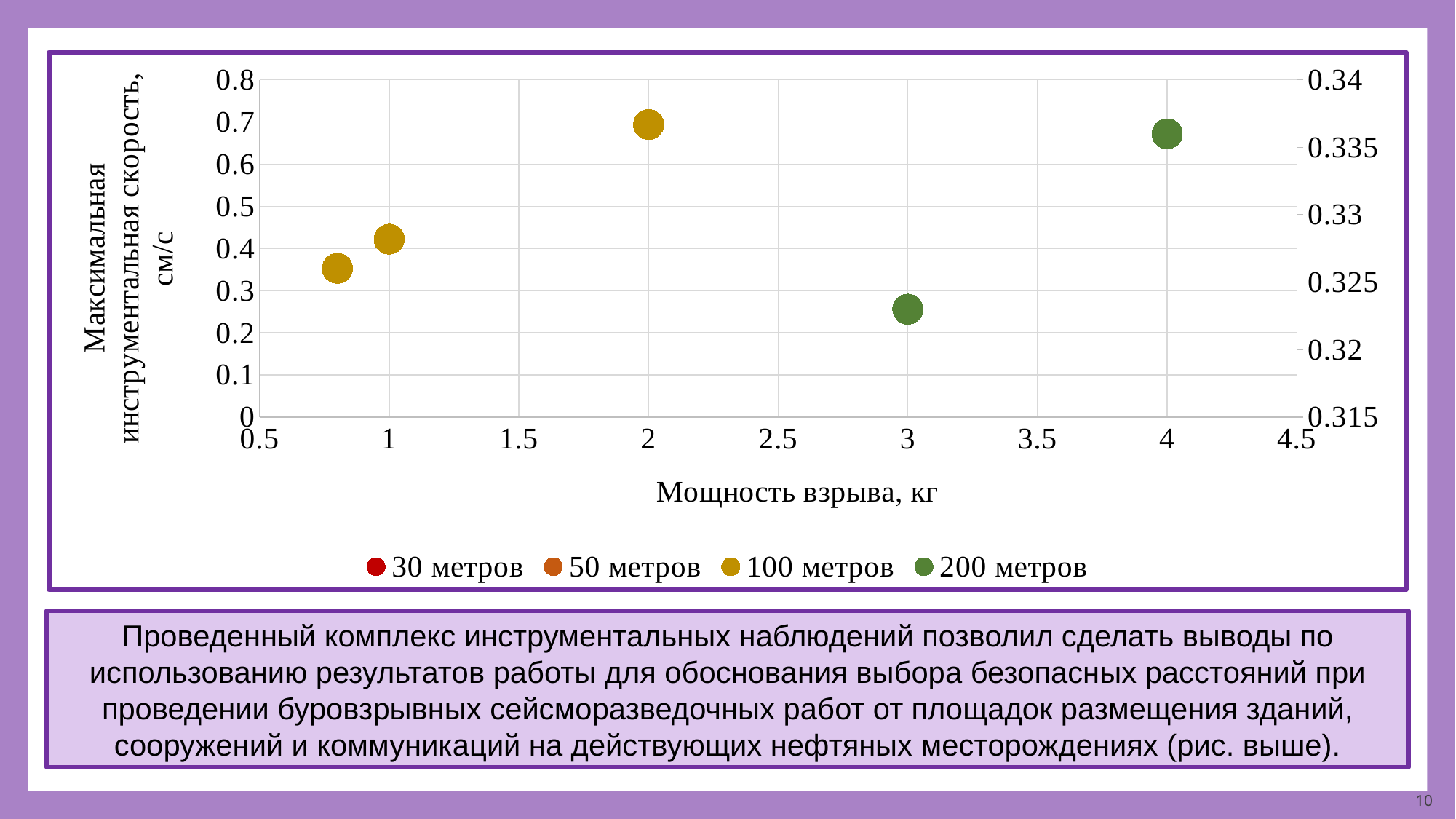
How many data points are plotted for the 200 метров series? 2 How many data points are plotted for the 100 метров series? 3 What is the title of the x axis? Мощность взрыва, кг Do the values of the 100 метров series rise or fall as Мощность взрыва increases? rise How many series does the legend list? 4 Which series has the point with the largest Мощность взрыва value? 200 метров Which series has more plotted points, 100 метров or 200 метров? 100 метров Reading the left axis, is the 100 метров point at Мощность взрыва 2 кг greater or less than 0.5? greater What kind of chart is shown on the slide? scatter (bubble) chart How many data points are plotted on the chart in total? 5 What colour are the markers for the 200 метров series? green Reading the left axis, is the 100 метров point at Мощность взрыва 1 кг greater or less than 0.5? less